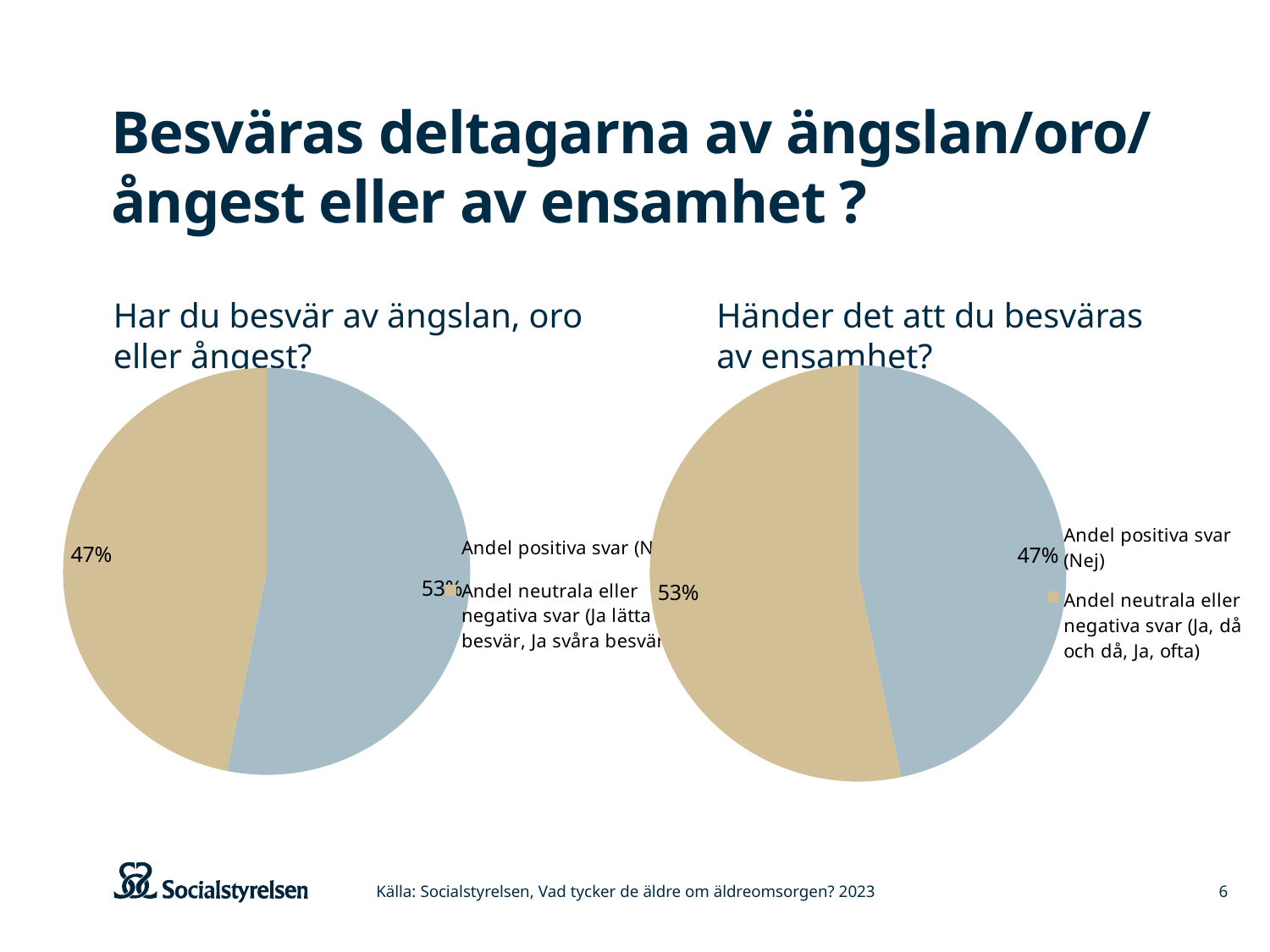
How many entries does the legend of the chart 'Händer det att du besväras av ensamhet?' list? 2 In the chart 'Händer det att du besväras av ensamhet?', what share of answers are positive (Nej)? 47% In the chart 'Händer det att du besväras av ensamhet?', what is the difference in percentage points between the neutral/negative share and the positive share? 6 percentage points How many slices does the chart 'Händer det att du besväras av ensamhet?' have? 2 How many pie charts are on the slide? 2 In the chart 'Har du besvär av ängslan, oro eller ångest?', which slice is larger: positive answers or neutral/negative answers? Positive answers (Nej) In the chart 'Har du besvär av ängslan, oro eller ångest?', what share of answers are positive (Nej)? 53% What kind of charts are shown on the slide? Pie charts In the chart 'Händer det att du besväras av ensamhet?', which slice is the largest? Andel neutrala eller negativa svar (Ja, då och då, Ja, ofta) In the chart 'Händer det att du besväras av ensamhet?', what colour is the slice for 'Andel positiva svar (Nej)'? Blue-grey In the chart 'Har du besvär av ängslan, oro eller ångest?', what share of answers are neutral or negative? 47% In the chart 'Händer det att du besväras av ensamhet?', what share of answers are neutral or negative (Ja, då och då, Ja, ofta)? 53%